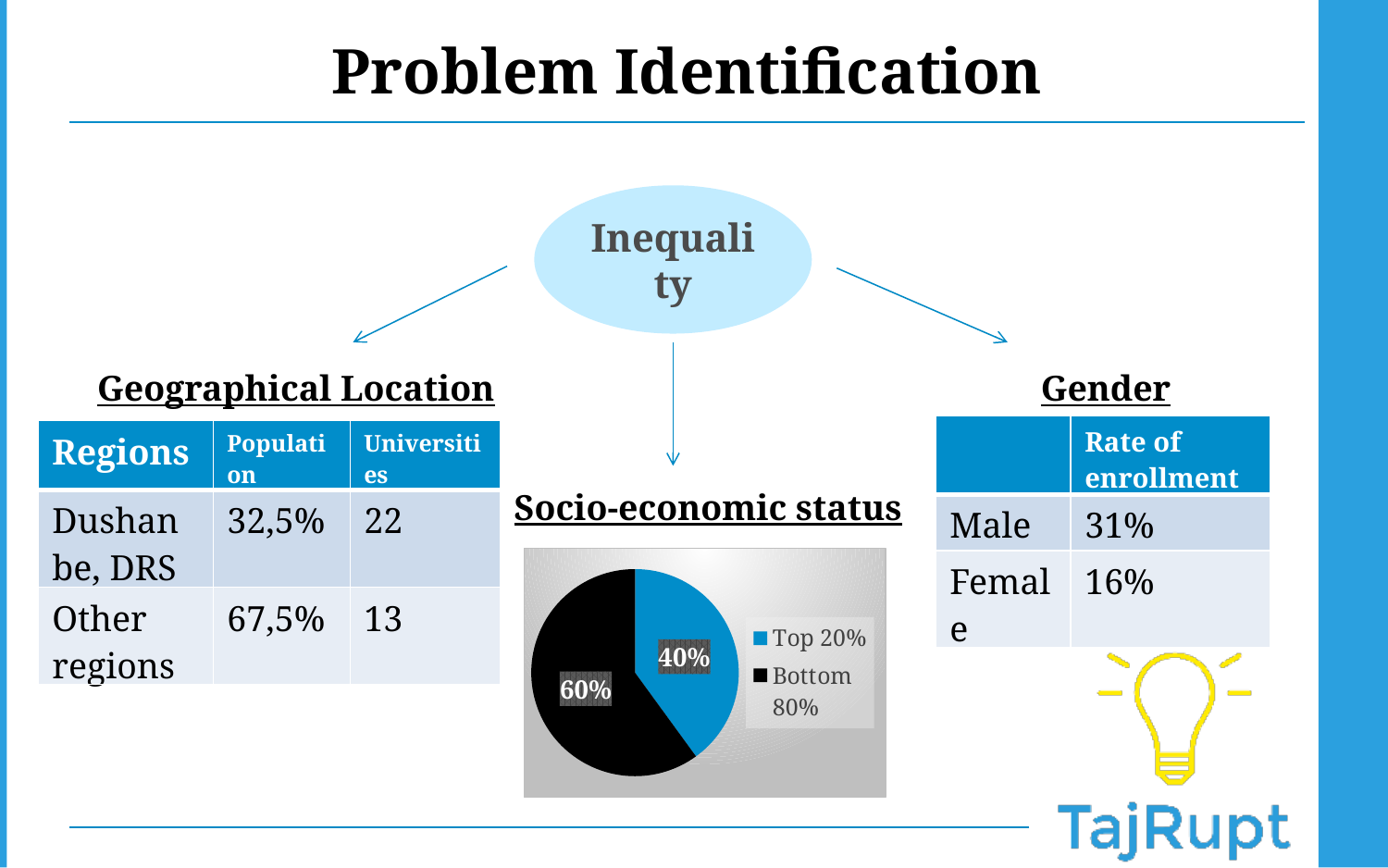
In the pie chart, what share is labelled for the Bottom 80% slice? 60% How many entries does the pie chart's legend list? 2 How many slices does the pie chart have? 2 What colour is the Bottom 80% slice in the pie chart? black What colour is the Top 20% slice in the pie chart? blue What kind of chart is shown under the Socio-economic status heading? pie chart Which slice of the pie chart is the largest? Bottom 80% In the pie chart, what share is labelled for the Top 20% slice? 40% In the pie chart, which slice is larger, Top 20% or Bottom 80%? Bottom 80% Which slice of the pie chart is the smallest? Top 20% What is the difference in percentage points between the Bottom 80% slice and the Top 20% slice in the pie chart? 20